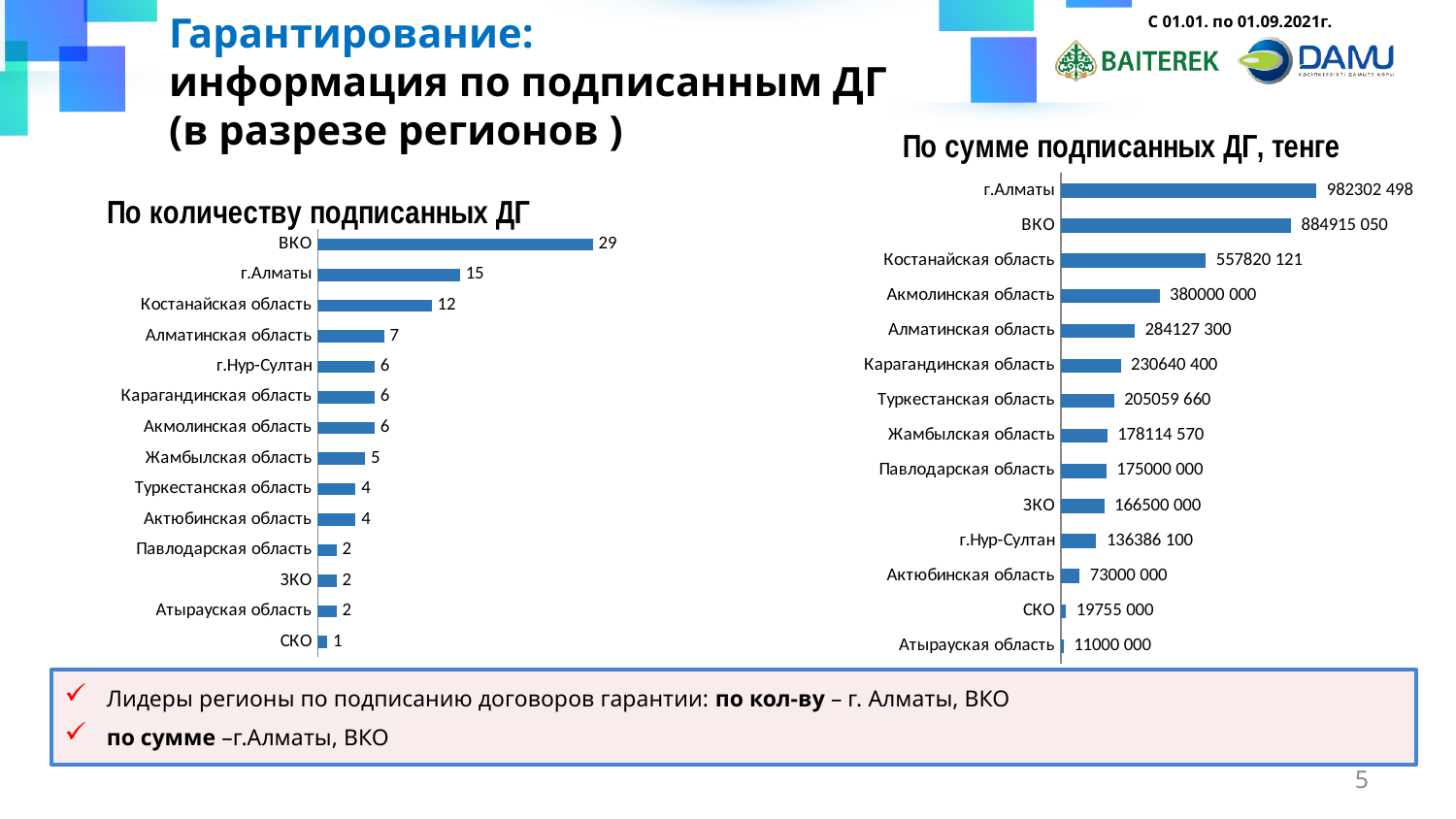
In the chart 'По количеству подписанных ДГ', what is the value for Жамбылская область? 5 In the chart 'По количеству подписанных ДГ', what is the difference between ВКО and г.Алматы? 14 In the chart 'По количеству подписанных ДГ', which is larger: Костанайская область or Алматинская область? Костанайская область What type of chart is 'По сумме подписанных ДГ, тенге'? Bar chart In the chart 'По сумме подписанных ДГ, тенге', which region has the lowest value? Атырауская область In the chart 'По сумме подписанных ДГ, тенге', which is larger: Павлодарская область or ЗКО? Павлодарская область In the chart 'По количеству подписанных ДГ', how many regions are shown? 14 In the chart 'По сумме подписанных ДГ, тенге', which region has the highest value? г.Алматы In the chart 'По сумме подписанных ДГ, тенге', what is the value for г.Нур-Султан? 136386 100 In the chart 'По количеству подписанных ДГ', what is the value for ВКО? 29 In the chart 'По сумме подписанных ДГ, тенге', what is the value for г.Алматы? 982302 498 In the chart 'По количеству подписанных ДГ', which region has the lowest value? СКО